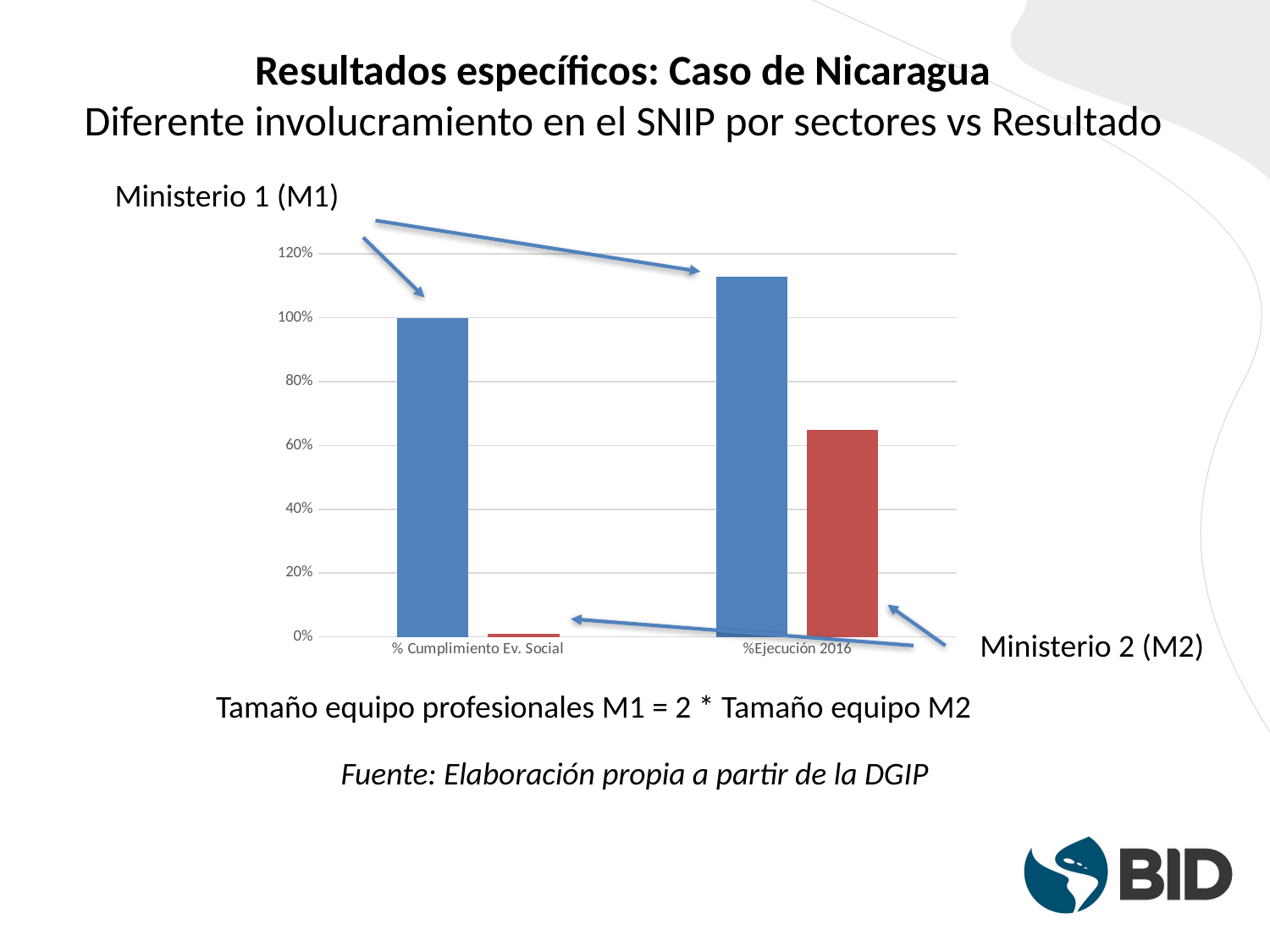
Which bar in the chart is the lowest? Ministerio 2 (M2) in % Cumplimiento Ev. Social Is the value for Ministerio 1 (M1) in %Ejecución 2016 greater or less than 100%? greater In the %Ejecución 2016 category, which ministry has the larger value, Ministerio 1 (M1) or Ministerio 2 (M2)? Ministerio 1 (M1) Is the value for Ministerio 2 (M2) in %Ejecución 2016 greater or less than 80%? less What is the value for Ministerio 1 (M1) in the % Cumplimiento Ev. Social category? 100% In the % Cumplimiento Ev. Social category, which ministry has the larger value, Ministerio 1 (M1) or Ministerio 2 (M2)? Ministerio 1 (M1) Is the value for Ministerio 2 (M2) in % Cumplimiento Ev. Social greater or less than 20%? less In which category does Ministerio 1 (M1) have its highest value? %Ejecución 2016 What colour are the bars for Ministerio 2 (M2)? red What kind of chart is shown on the slide? bar chart How many categories are shown on the x axis of the chart? 2 What is the highest tick value shown on the y axis of the chart? 120%